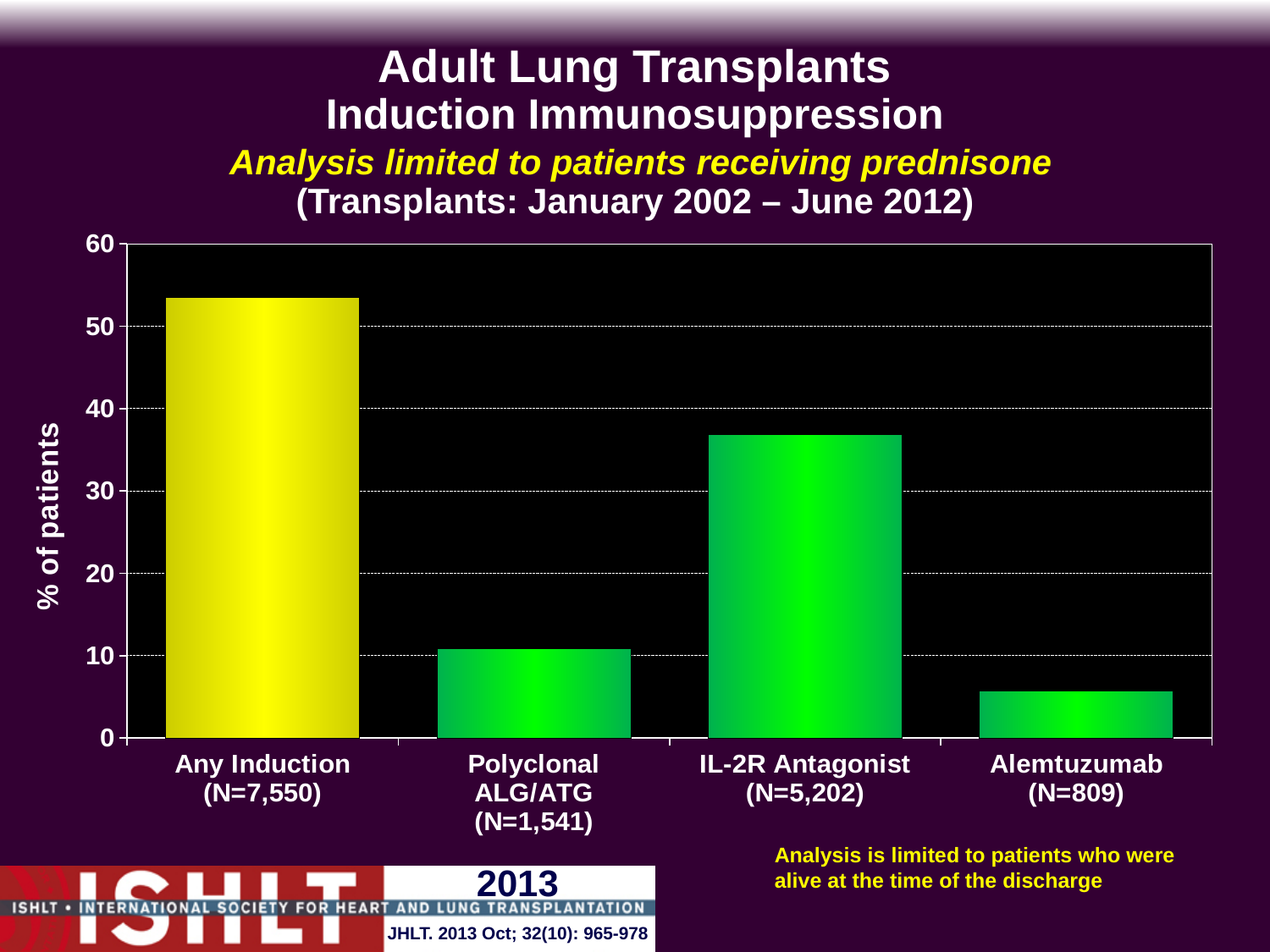
What is the label on the y axis of the chart? % of patients Is the value for Alemtuzumab greater or less than 10? less Is the value for IL-2R Antagonist greater or less than 30? greater How many categories are shown on the x axis of the chart? 4 Which category has the highest percentage of patients? Any Induction Which category has the lowest percentage of patients? Alemtuzumab Is the value for IL-2R Antagonist greater or less than 40? less Which is larger, the value for IL-2R Antagonist or the value for Polyclonal ALG/ATG? IL-2R Antagonist What kind of chart is shown on the slide? bar chart What is the N shown for the IL-2R Antagonist category? N=5,202